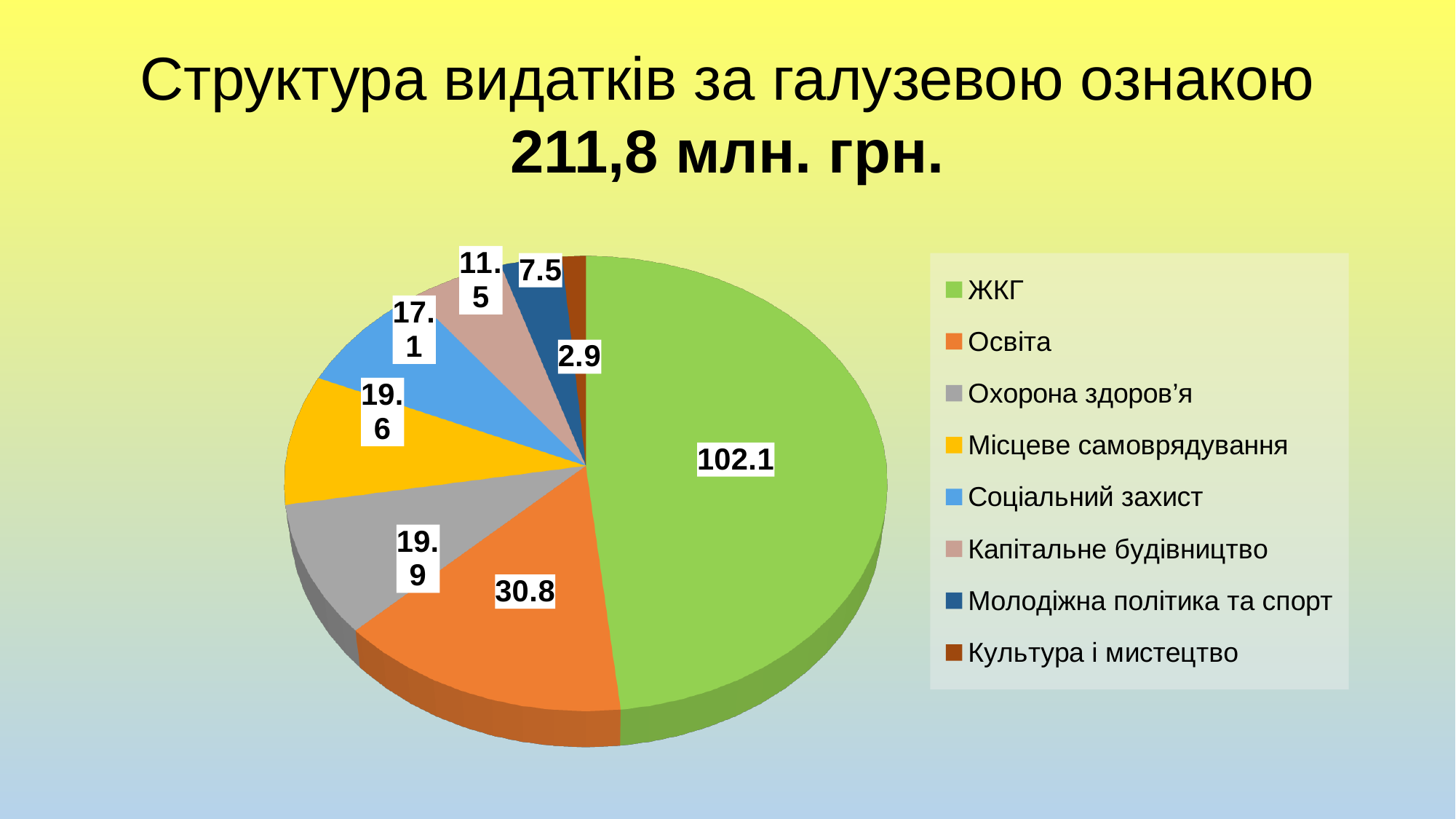
Which category has the largest slice of the pie? ЖКГ What is the value for Соціальний захист? 17.1 What type of chart is shown on the slide? Pie chart What is the value for Молодіжна політика та спорт? 7.5 Which is larger, the value for Охорона здоров’я or the value for Місцеве самоврядування? Охорона здоров’я What is the difference between the values for Соціальний захист and Капітальне будівництво? 5.6 What is the value for ЖКГ? 102.1 How many categories does the legend list? 8 What is the difference between the values for ЖКГ and Освіта? 71.3 Which category has the smallest slice of the pie? Культура і мистецтво What is the value for Освіта? 30.8 What total amount is stated in the slide title? 211,8 млн. грн.